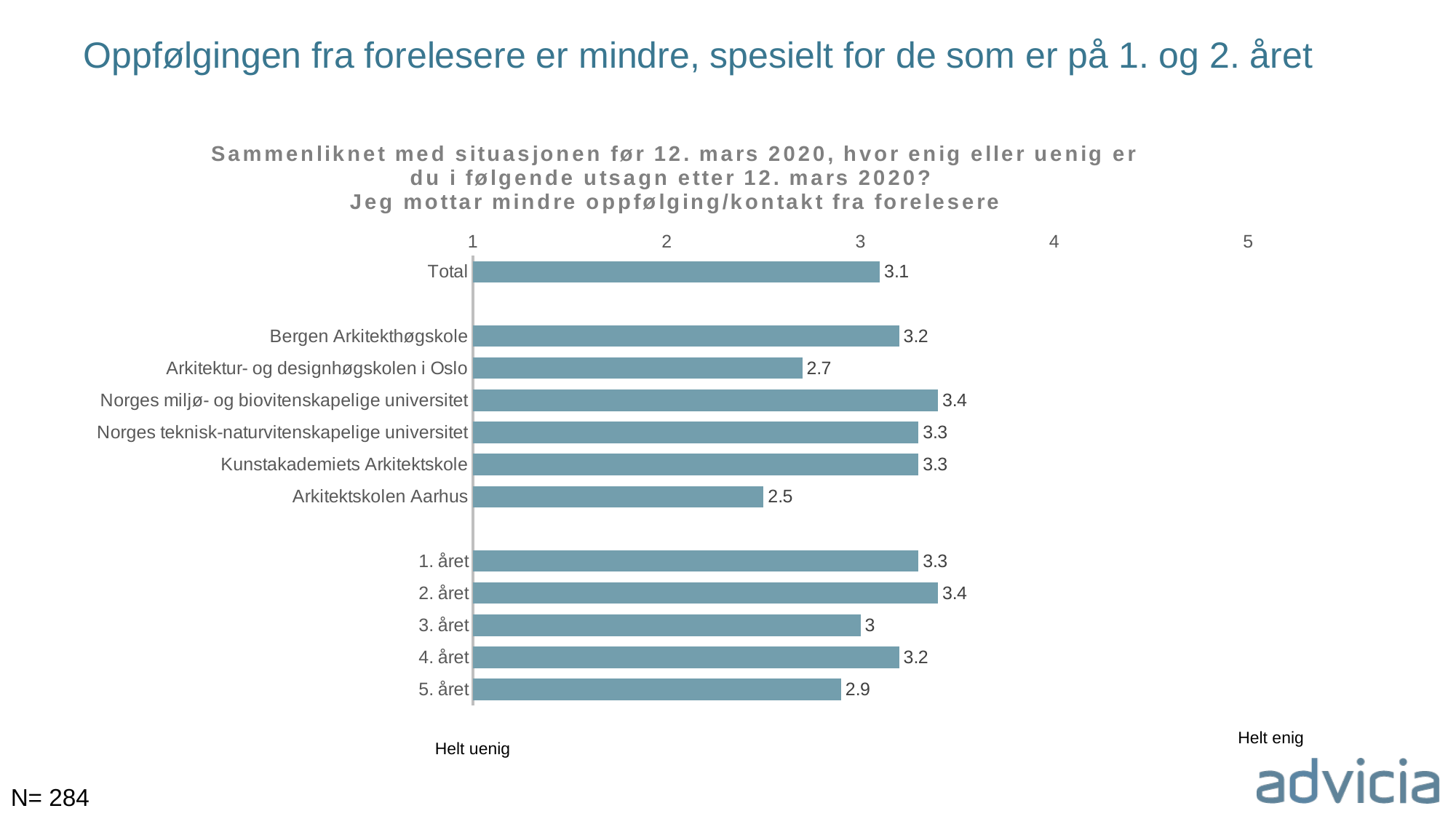
What is the value for Arkitektur- og designhøgskolen i Oslo? 2.7 Which is larger, the value for 2. året or the value for 4. året? 2. året Which category has the lowest value in the chart? Arkitektskolen Aarhus What is the difference between the values for Norges miljø- og biovitenskapelige universitet and Arkitektskolen Aarhus? 0.9 How many bars are plotted in the chart? 12 What is the value for 3. året? 3 What kind of chart is shown on the slide? Bar chart What is the value for Total? 3.1 What is the value for 5. året? 2.9 Which year group (1. året to 5. året) has the lowest value? 5. året Which institution has the highest value? Norges miljø- og biovitenskapelige universitet Is the value for Arkitektskolen Aarhus greater or less than 3? less